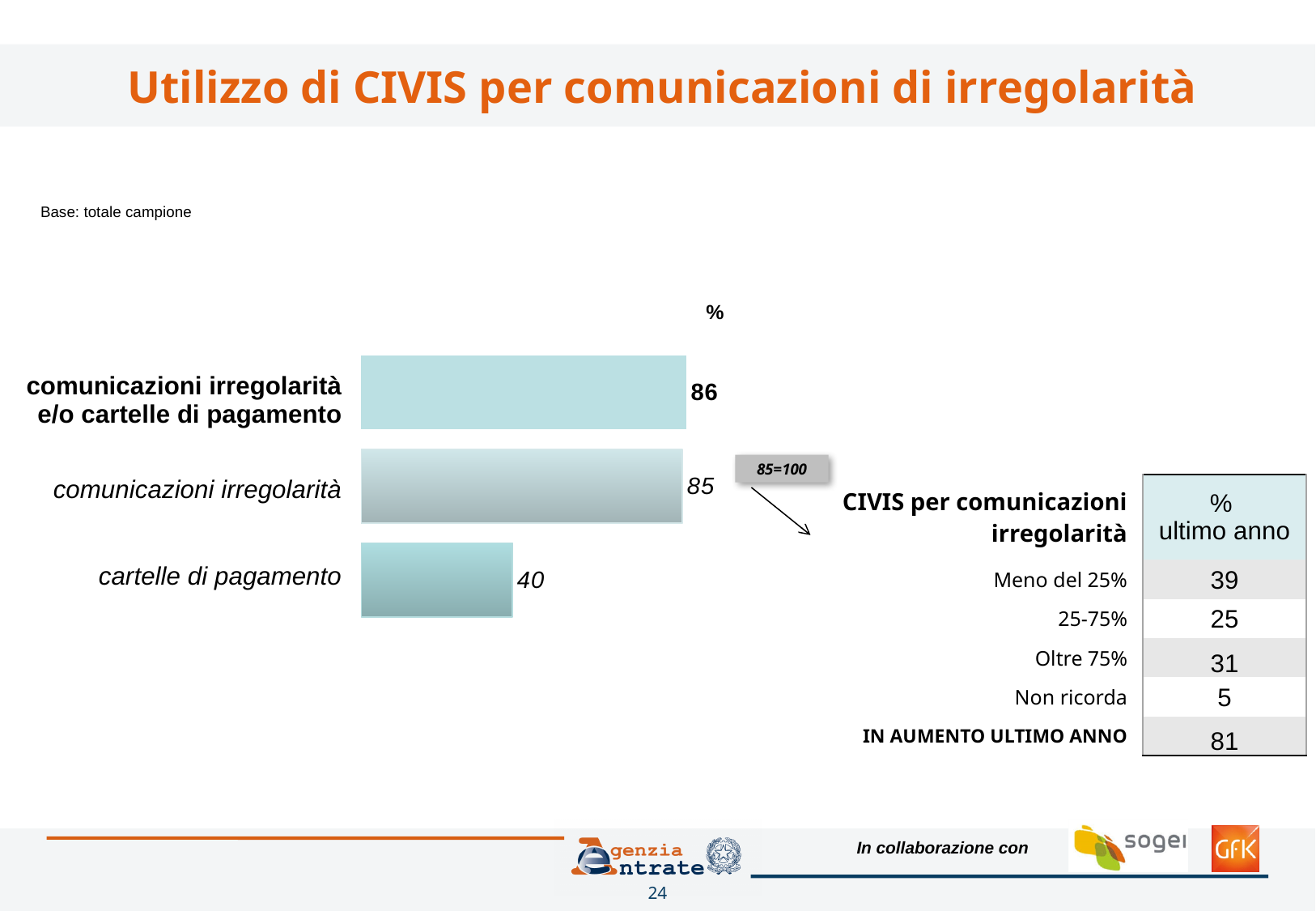
Which category has the lowest value in the bar chart? cartelle di pagamento What is the value for 'comunicazioni irregolarità' in the bar chart? 85 What unit symbol is shown above the bar values in the chart? % How many categories are shown in the bar chart? 3 What is the title of the slide containing the chart? Utilizzo di CIVIS per comunicazioni di irregolarità Which is larger: the value for 'comunicazioni irregolarità' or the value for 'cartelle di pagamento'? comunicazioni irregolarità Which category has the highest value in the bar chart? comunicazioni irregolarità e/o cartelle di pagamento What is the difference between the values for 'comunicazioni irregolarità' and 'cartelle di pagamento'? 45 What is the value for 'cartelle di pagamento' in the bar chart? 40 What is the difference between the values for 'comunicazioni irregolarità e/o cartelle di pagamento' and 'cartelle di pagamento'? 46 What is the value for 'comunicazioni irregolarità e/o cartelle di pagamento' in the bar chart? 86 What kind of chart is shown on the slide? bar chart